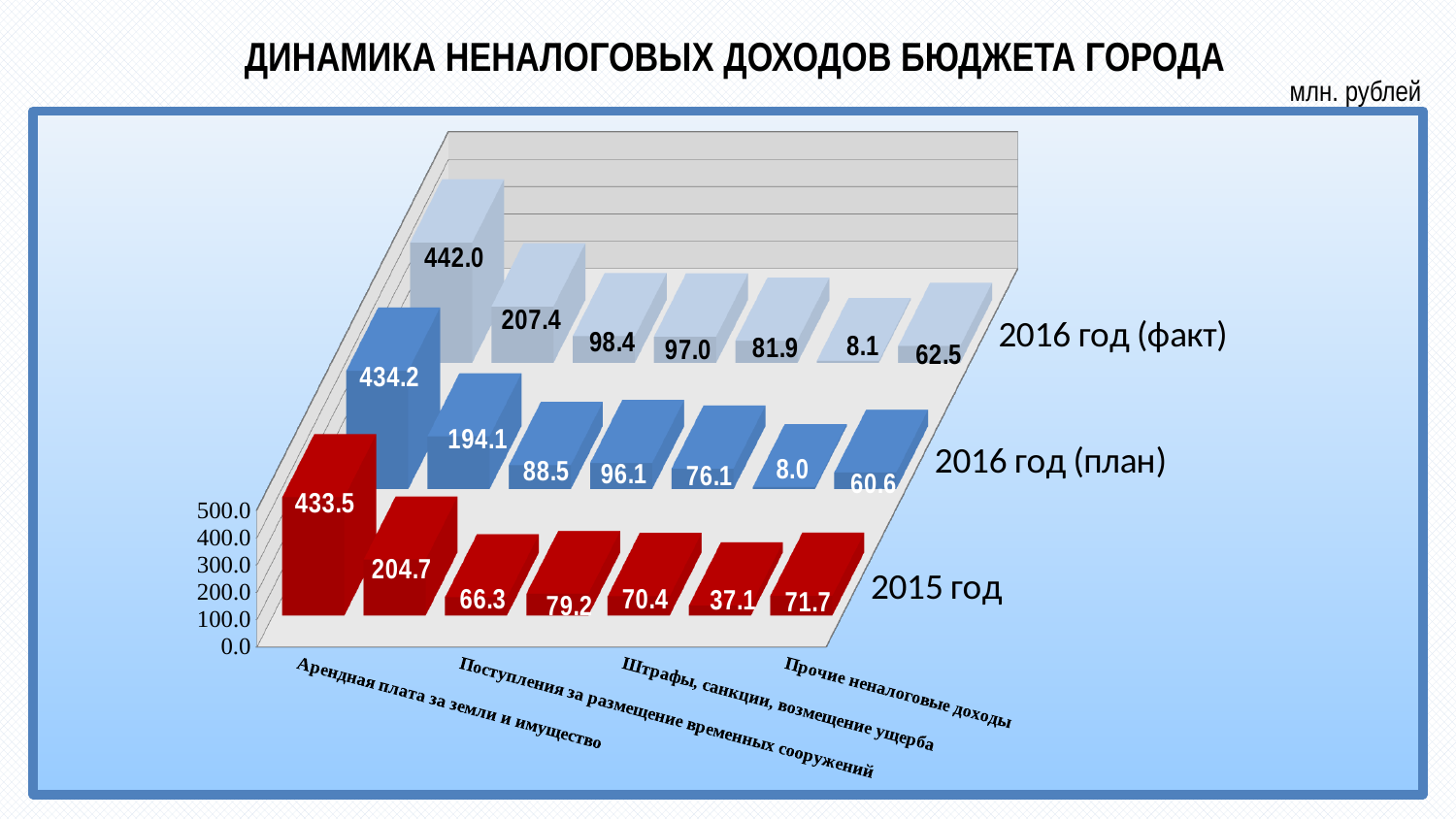
What kind of chart is shown on the slide? Bar chart What is the value for Прочие неналоговые доходы in the 2015 год series? 71.7 What is the lowest value shown in the 2015 год series? 37.1 What is the value for Арендная плата за земли и имущество in the 2015 год series? 433.5 Which category has the highest value in the 2016 год (факт) series? Арендная плата за земли и имущество How many bars are plotted in each series? 7 What is the value for Арендная плата за земли и имущество in the 2016 год (факт) series? 442.0 What is the value for Прочие неналоговые доходы in the 2016 год (план) series? 60.6 Which is larger for Прочие неналоговые доходы: the 2015 год value or the 2016 год (факт) value? 2015 год In what units are the values on the chart given? млн. рублей What is the difference between the 2016 год (факт) and 2015 год values for Арендная плата за земли и имущество? 8.5 How many series does the chart show? 3